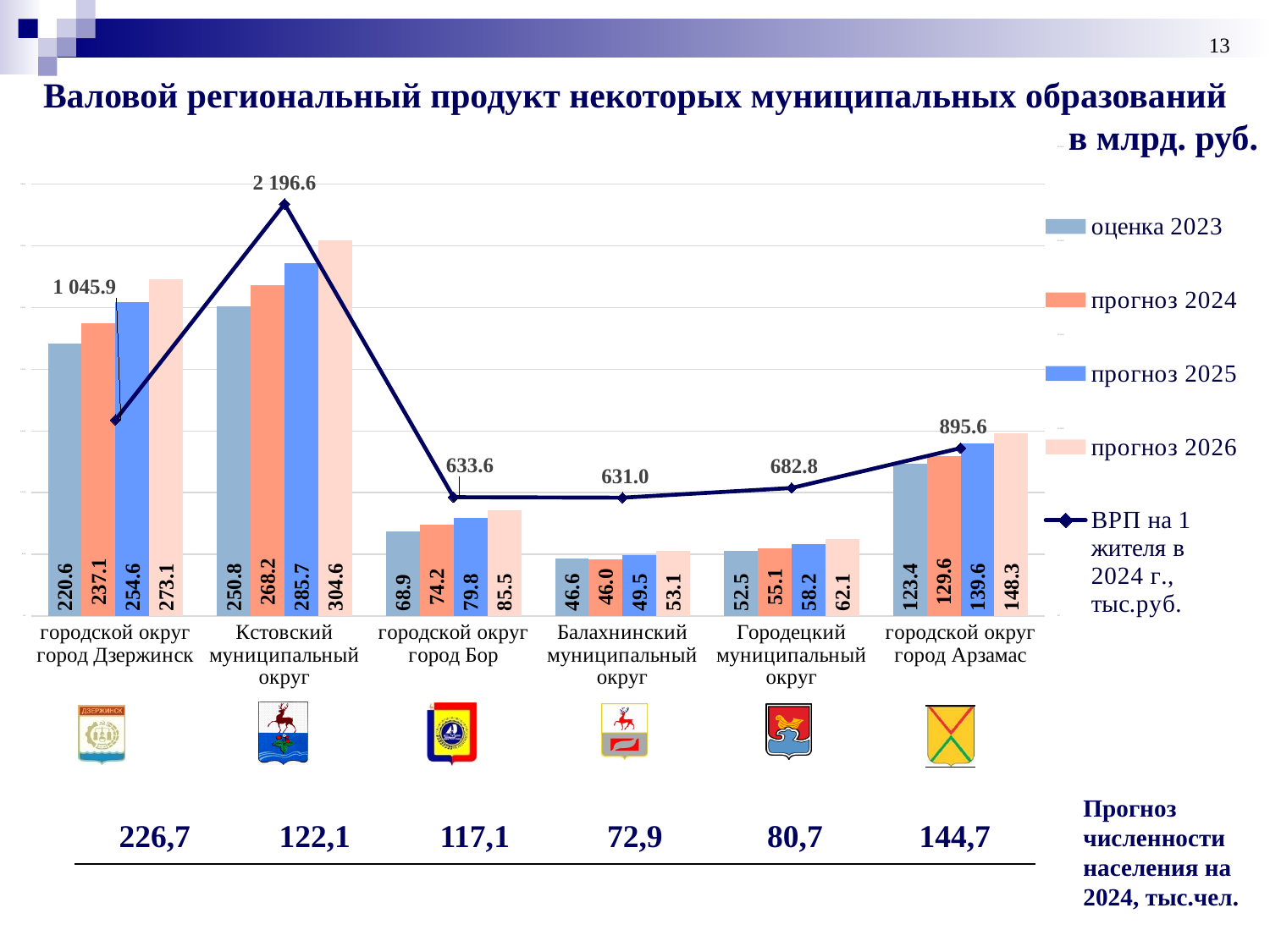
How many municipalities are shown on the x axis of the chart? 6 What is the difference between the прогноз 2026 and оценка 2023 values for городской округ город Дзержинск? 52.5 Which municipality has the lowest прогноз 2024 value? Балахнинский муниципальный округ What is the ВРП на 1 жителя в 2024 г. value for городской округ город Бор? 633.6 What is the оценка 2023 value for городской округ город Арзамас? 123.4 What kind of chart is shown on the slide? Combined bar and line chart How many series does the chart legend list? 5 Which is larger: the прогноз 2025 value for Городецкий муниципальный округ or for городской округ город Бор? городской округ город Бор Which municipality has the highest ВРП на 1 жителя в 2024 г.? Кстовский муниципальный округ In what units are the bar values on the chart expressed, according to the slide? млрд. руб. Do the bar values for городской округ город Арзамас rise or fall from оценка 2023 to прогноз 2026? Rise What is the прогноз 2026 value for Кстовский муниципальный округ? 304.6